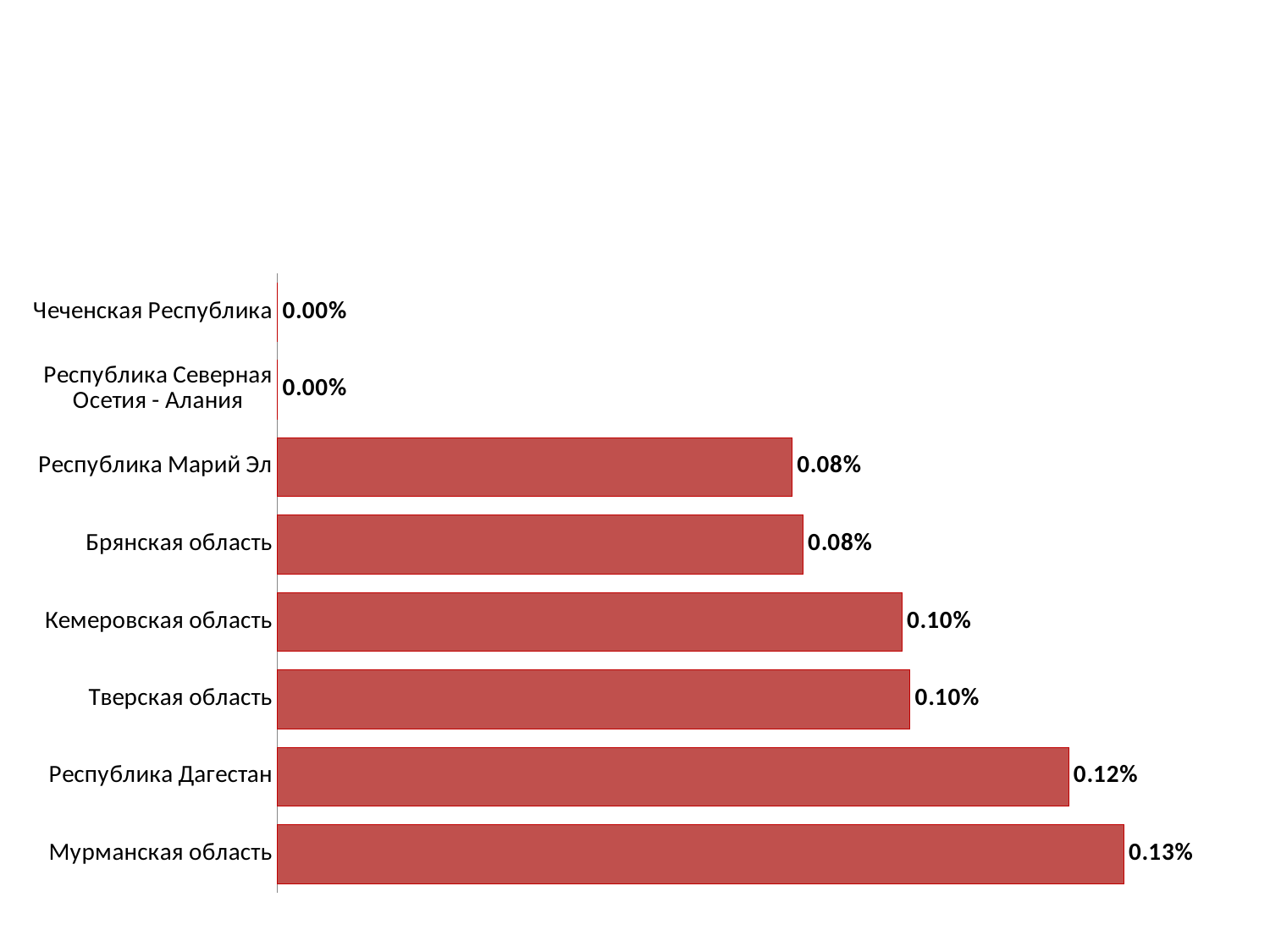
What is the value shown for Кемеровская область? 0.10% How many categories are shown in the chart? 8 What is the difference between the values for Мурманская область and Республика Дагестан? 0.01% What is the value shown for Чеченская Республика? 0.00% What kind of chart is shown on the slide? Bar chart Which is larger, the value for Республика Дагестан or the value for Тверская область? Республика Дагестан What is the difference between the values for Мурманская область and Республика Марий Эл? 0.05% What is the value shown for Мурманская область? 0.13% Which category has the highest value? Мурманская область What is the value shown for Республика Дагестан? 0.12% What is the value shown for Брянская область? 0.08% How many categories have a value of 0.00%? 2